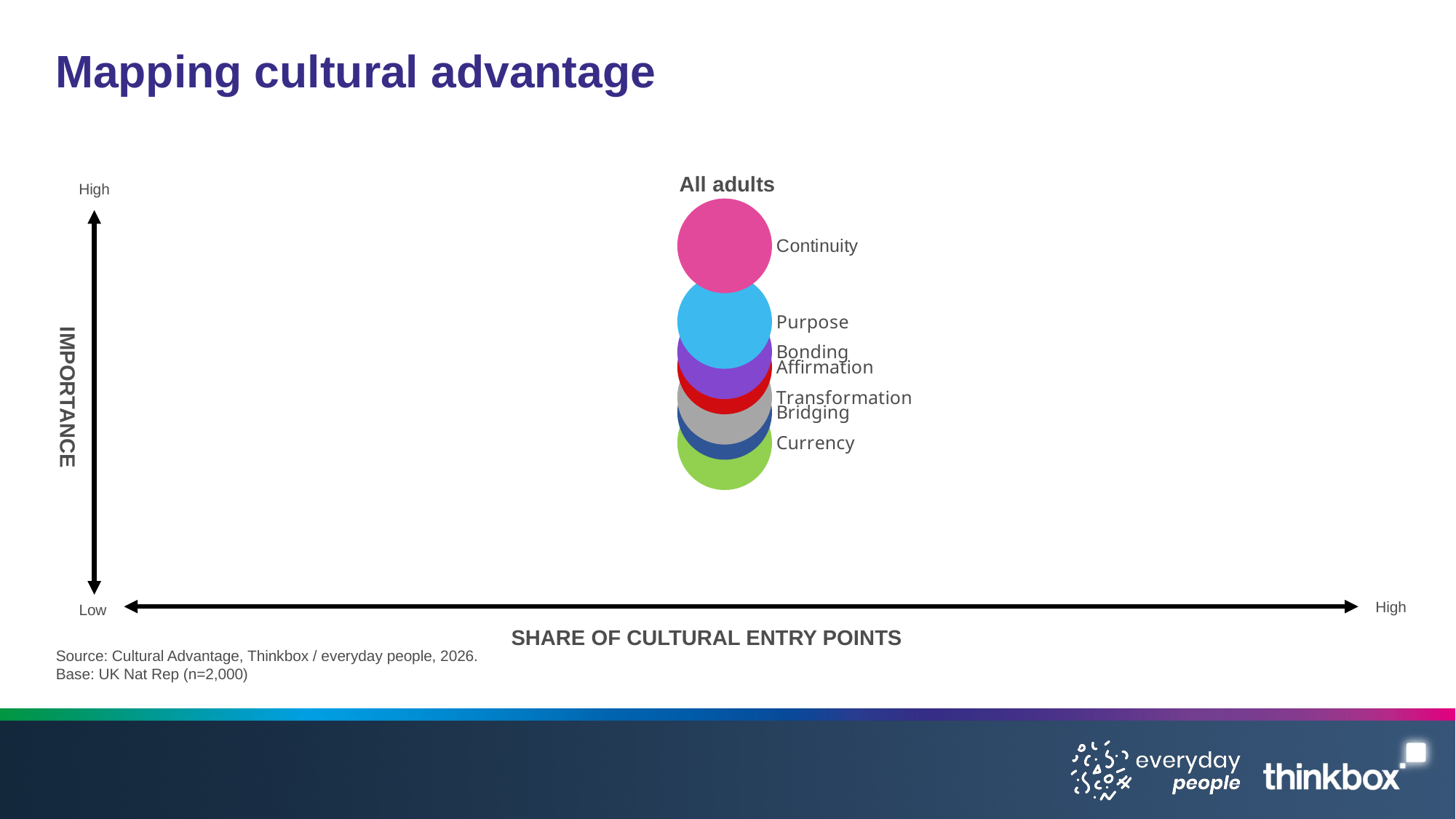
Which bubble is positioned lowest on the Importance axis? Currency What is the label of the vertical axis? Importance How many labelled bubbles are plotted on the chart? 7 What is the label of the horizontal axis? Share of cultural entry points Which is positioned higher on the Importance axis, Purpose or Currency? Purpose Which bubble is positioned highest on the Importance axis? Continuity Which is positioned higher on the Importance axis, Continuity or Purpose? Continuity What kind of chart is shown on the slide? Bubble chart